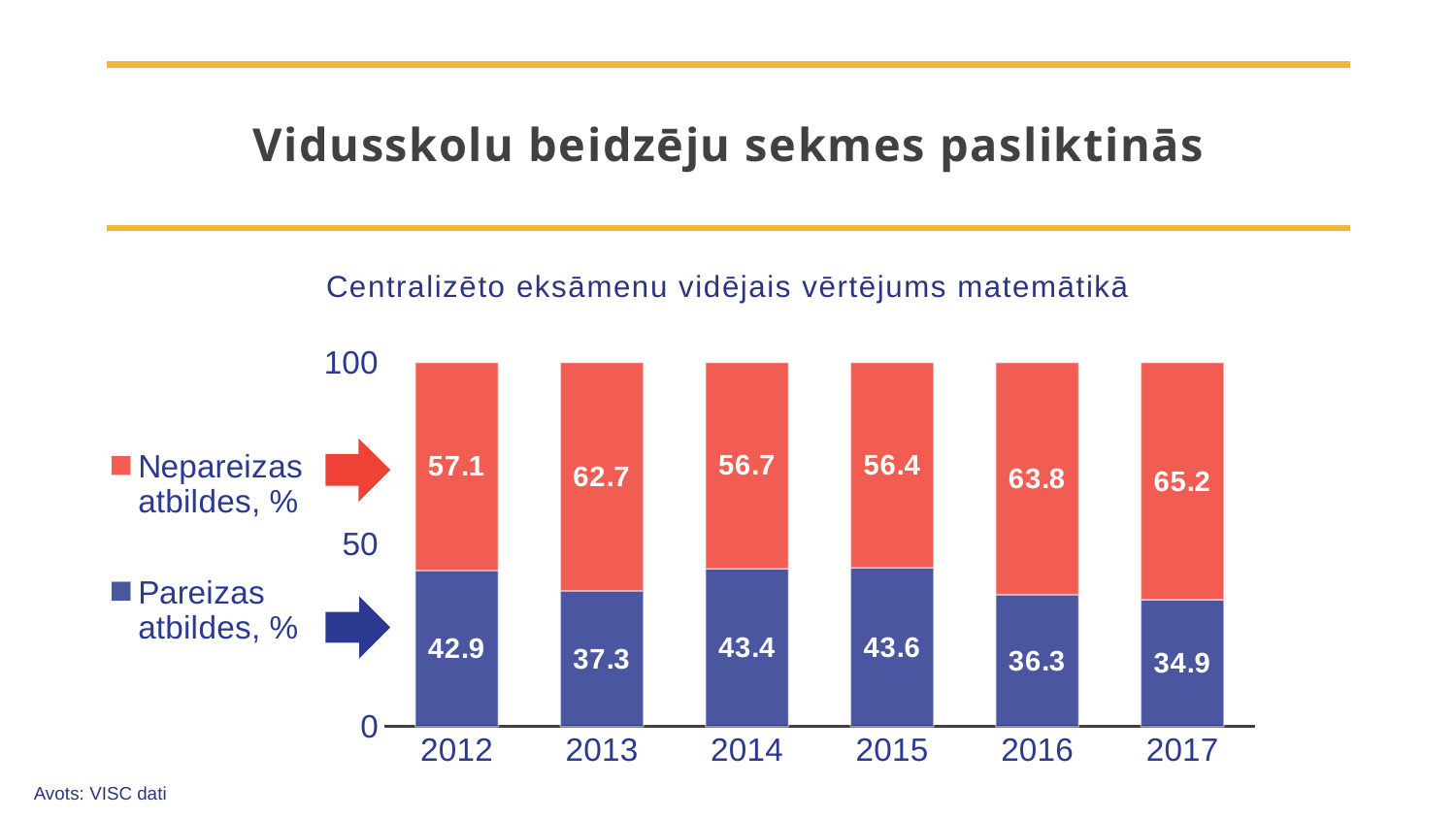
How many series does the legend list? 2 What is the value for Nepareizas atbildes, % in 2013? 62.7 In which year is Pareizas atbildes, % the lowest? 2017 How many years are shown on the x axis? 6 Is the value for Nepareizas atbildes, % in 2016 greater or less than 50? greater What is the total of the stacked bar for 2013? 100 What is the value for Pareizas atbildes, % in 2015? 43.6 In which year is Nepareizas atbildes, % the highest? 2017 What is the difference between Nepareizas atbildes, % in 2017 and in 2012? 8.1 Which is larger: Pareizas atbildes, % in 2014 or in 2016? 2014 What is the title of the chart? Centralizēto eksāmenu vidējais vērtējums matemātikā What kind of chart is shown on the slide? stacked bar chart